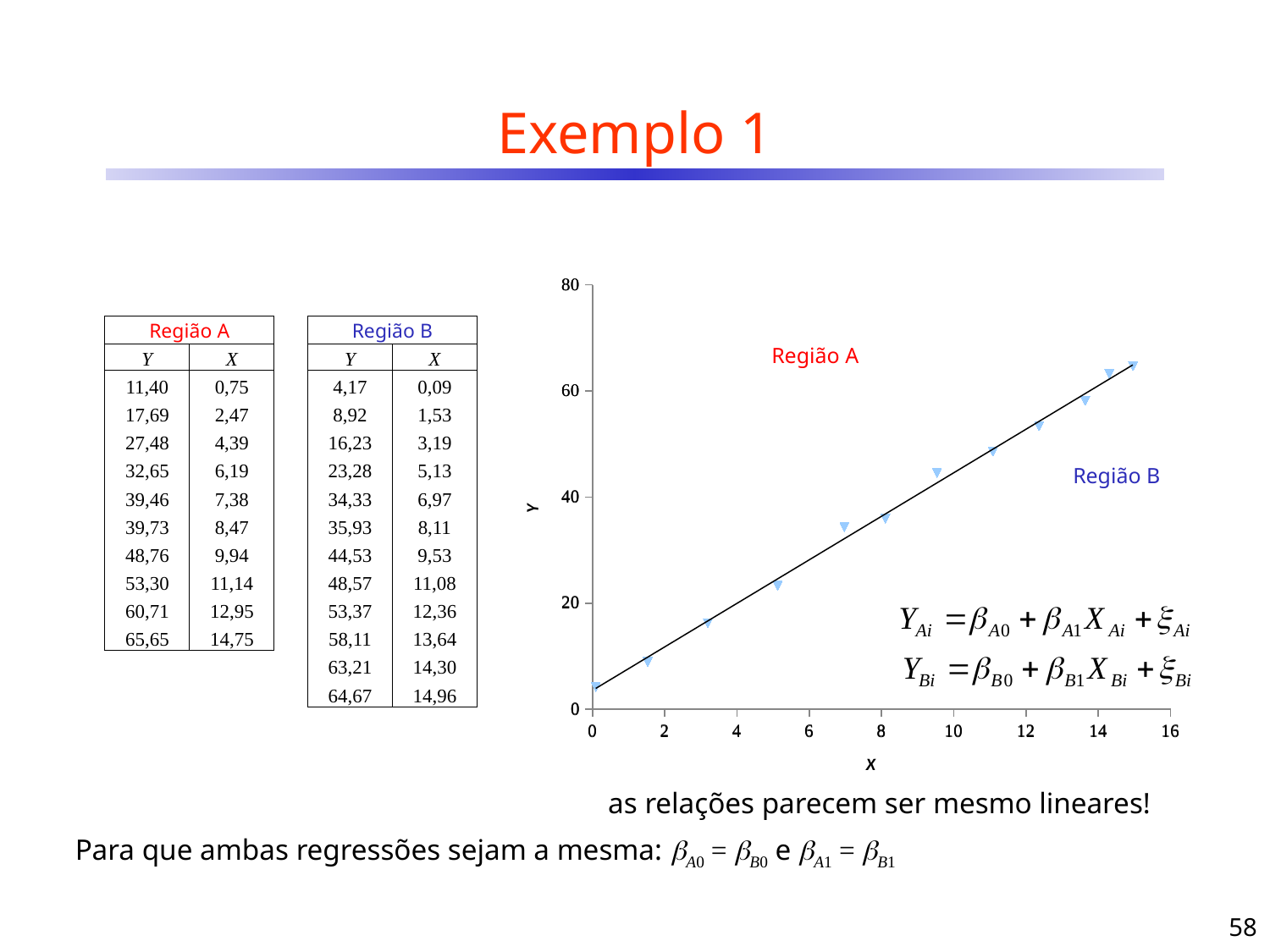
Is the Y value of the point near X = 5 greater or less than 20? greater Is the Y value of the point near X = 7 greater or less than 40? less Do the plotted Y values rise or fall as X increases? Rise What kind of chart is shown on the slide? Scatter plot with a fitted line What is the highest tick value shown on the Y axis of the chart? 80 Is the Y value of the point near X = 3 greater or less than 20? less How many data points are plotted on the chart? 12 What is the label of the horizontal axis of the chart? X Which point has the highest Y value: the one near X = 1.5 or the one near X = 13.6? The one near X = 13.6